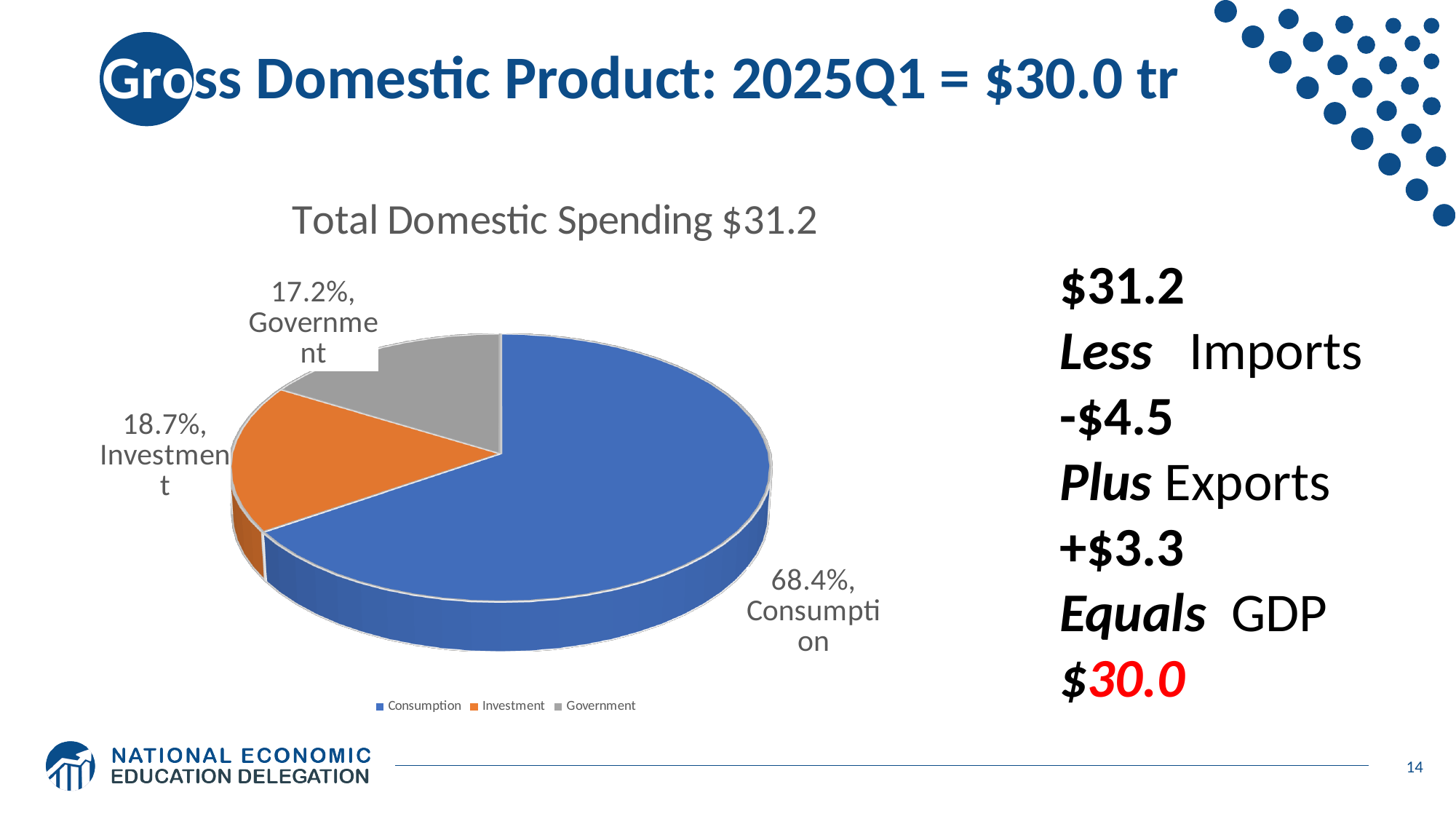
What colour is the Consumption slice? Blue What share of the pie does Government represent? 17.2% Which is larger, the Investment share or the Government share? Investment What share of the pie does Consumption represent? 68.4% Which category has the smallest slice of the pie? Government What is the title of the chart? Total Domestic Spending $31.2 What kind of chart is shown on the slide? Pie chart What is the difference in percentage points between the Investment and Government shares? 1.5 How many categories are shown in the pie chart? 3 What share of the pie does Investment represent? 18.7% Which category has the largest slice of the pie? Consumption What is the difference in percentage points between the Consumption and Investment shares? 49.7